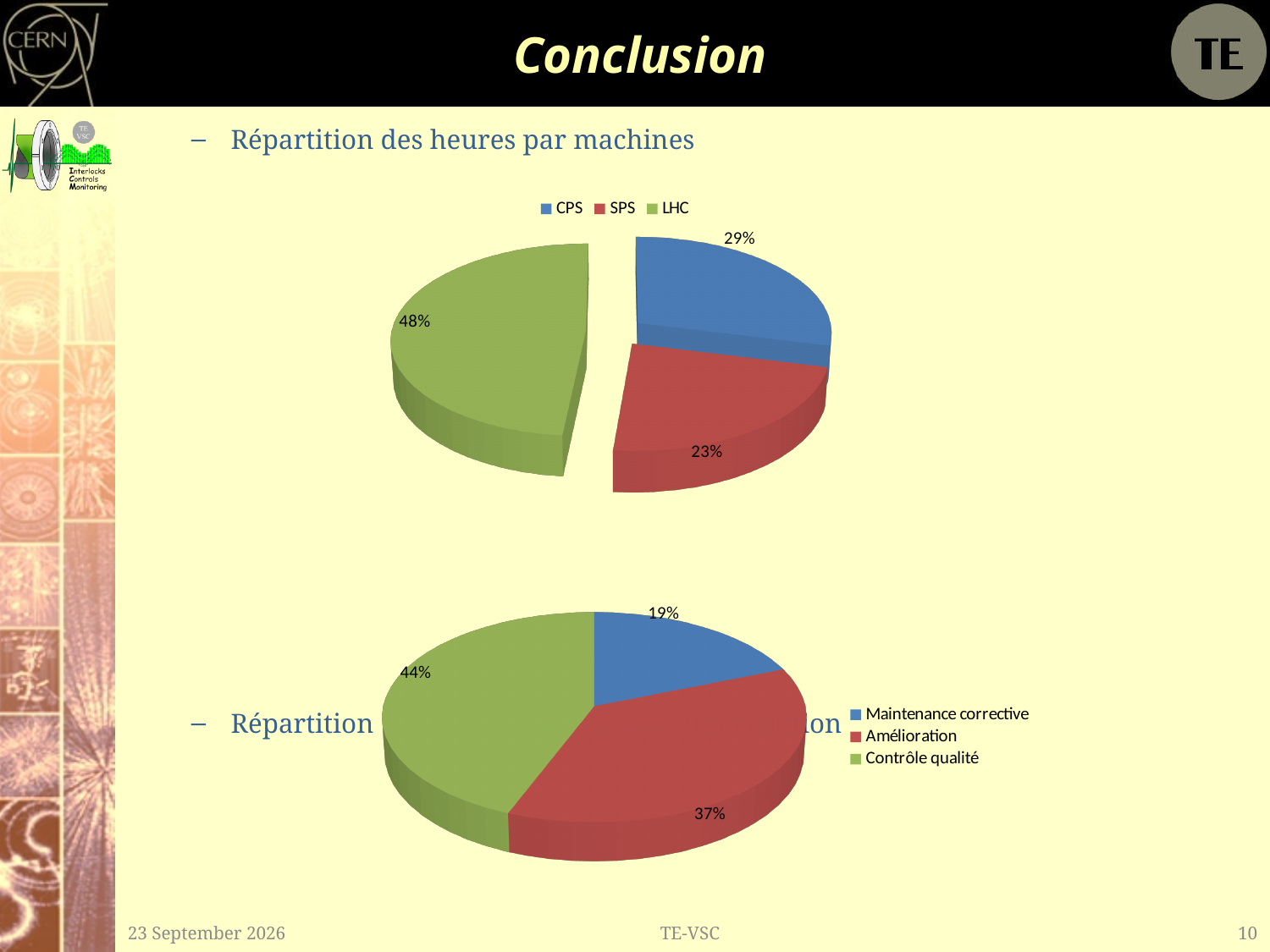
In the top pie chart, which machine has the smallest share? SPS In the top pie chart, what is the difference in percentage points between the LHC and CPS shares? 19 In the bottom pie chart, what share is labelled for Amélioration? 37% In the bottom pie chart, what colour is the Contrôle qualité slice? Green In the bottom pie chart, which category has the largest share? Contrôle qualité In the top pie chart, which machine has the largest share? LHC In the bottom pie chart, which is larger: Amélioration or Maintenance corrective? Amélioration In the top pie chart, what share is labelled for SPS? 23% In the top pie chart, what share is labelled for LHC? 48% In the bottom pie chart, what share is labelled for Maintenance corrective? 19% How many entries does the legend of the top pie chart list? 3 What kind of chart is the top chart on the slide? Pie chart